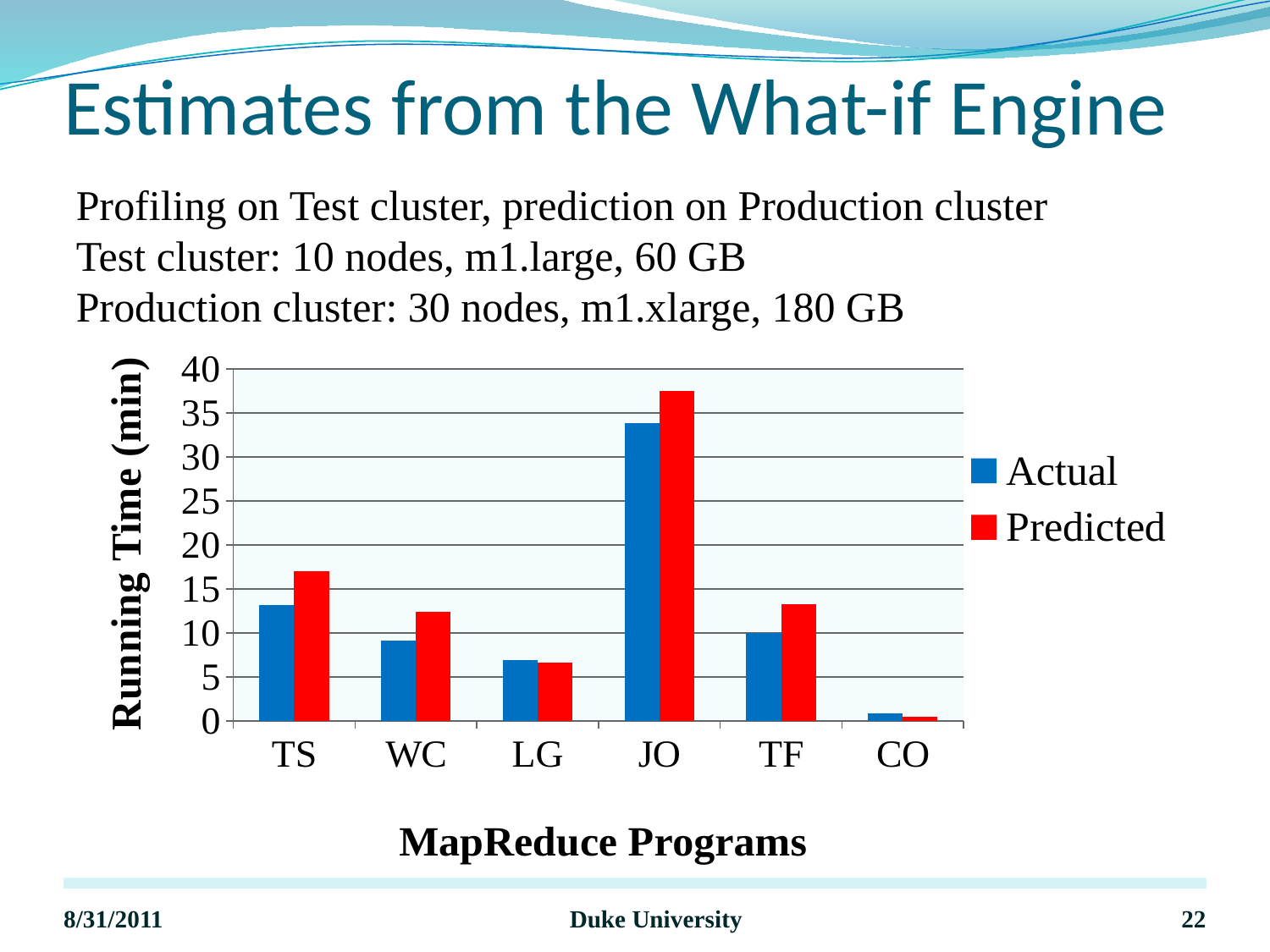
Which MapReduce program has the highest Actual running time? JO Which MapReduce program has the lowest Predicted running time? CO Is the Actual running time for WC greater or less than 10? less Which is larger: the Predicted running time for JO or for TF? JO For TS, which is larger: the Actual or the Predicted running time? Predicted How many series does the legend list? 2 Is the Predicted running time for TS greater or less than 15? greater Is the Actual running time for CO greater or less than 5? less How many MapReduce programs are shown on the x axis? 6 What is the label of the y axis? Running Time (min) What kind of chart is shown on the slide? bar chart